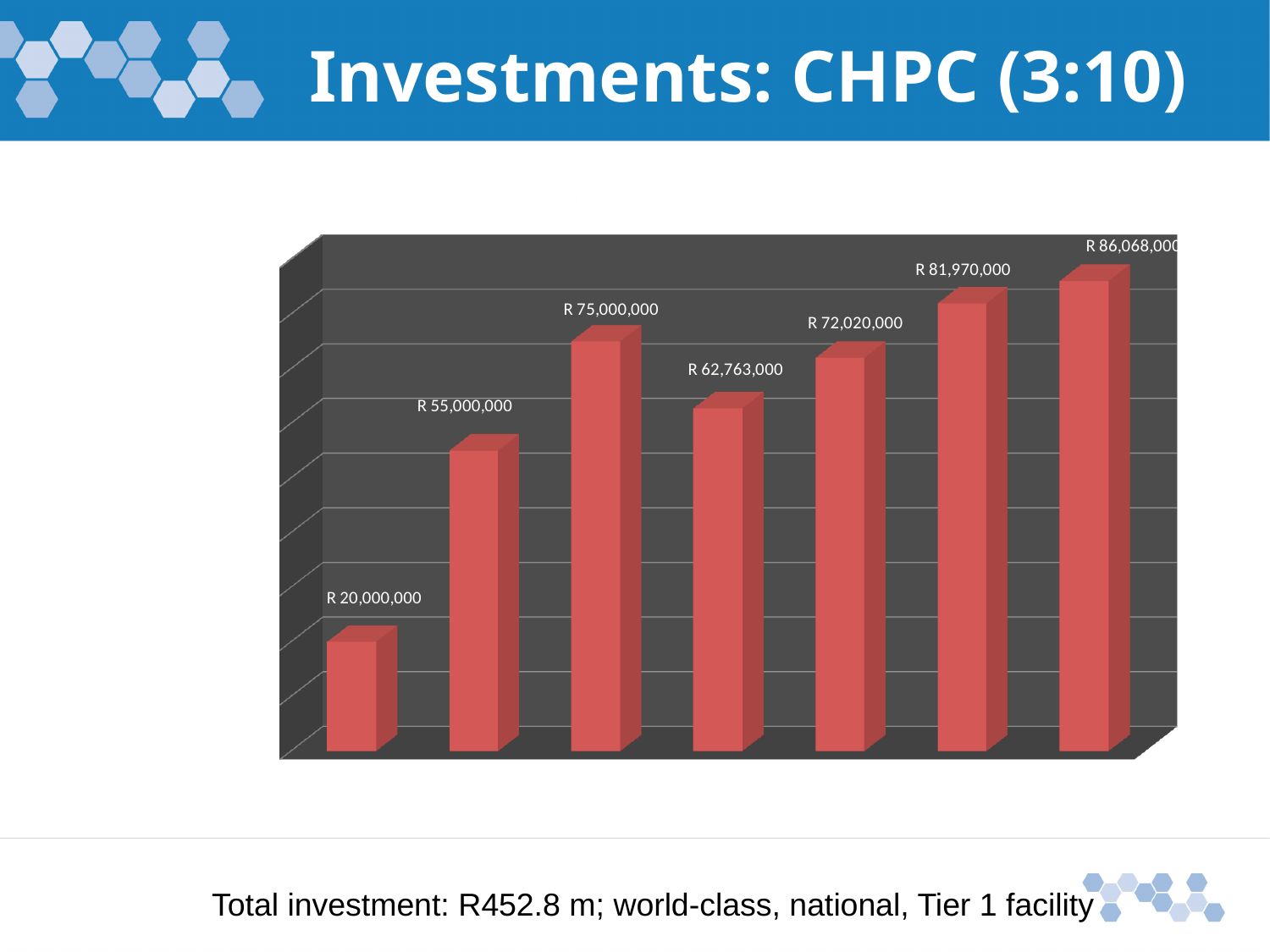
What is the value shown on the second bar from the left? R 55,000,000 What kind of chart is shown on the slide? bar chart What is the difference between the value of the third bar (R 75,000,000) and the fourth bar (R 62,763,000)? R 12,237,000 What is the value shown on the fourth bar from the left? R 62,763,000 What is the value shown on the last (rightmost) bar? R 86,068,000 What is the lowest value labelled on any bar in the chart? R 20,000,000 What is the highest value labelled on any bar in the chart? R 86,068,000 Which is larger, the value of the third bar or the value of the fifth bar? the third bar (R 75,000,000) According to the text below the chart, what is the total investment? R452.8 m What is the difference between the rightmost bar (R 86,068,000) and the sixth bar (R 81,970,000)? R 4,098,000 How many bars are plotted in the chart? 7 What is the value shown on the first (leftmost) bar? R 20,000,000